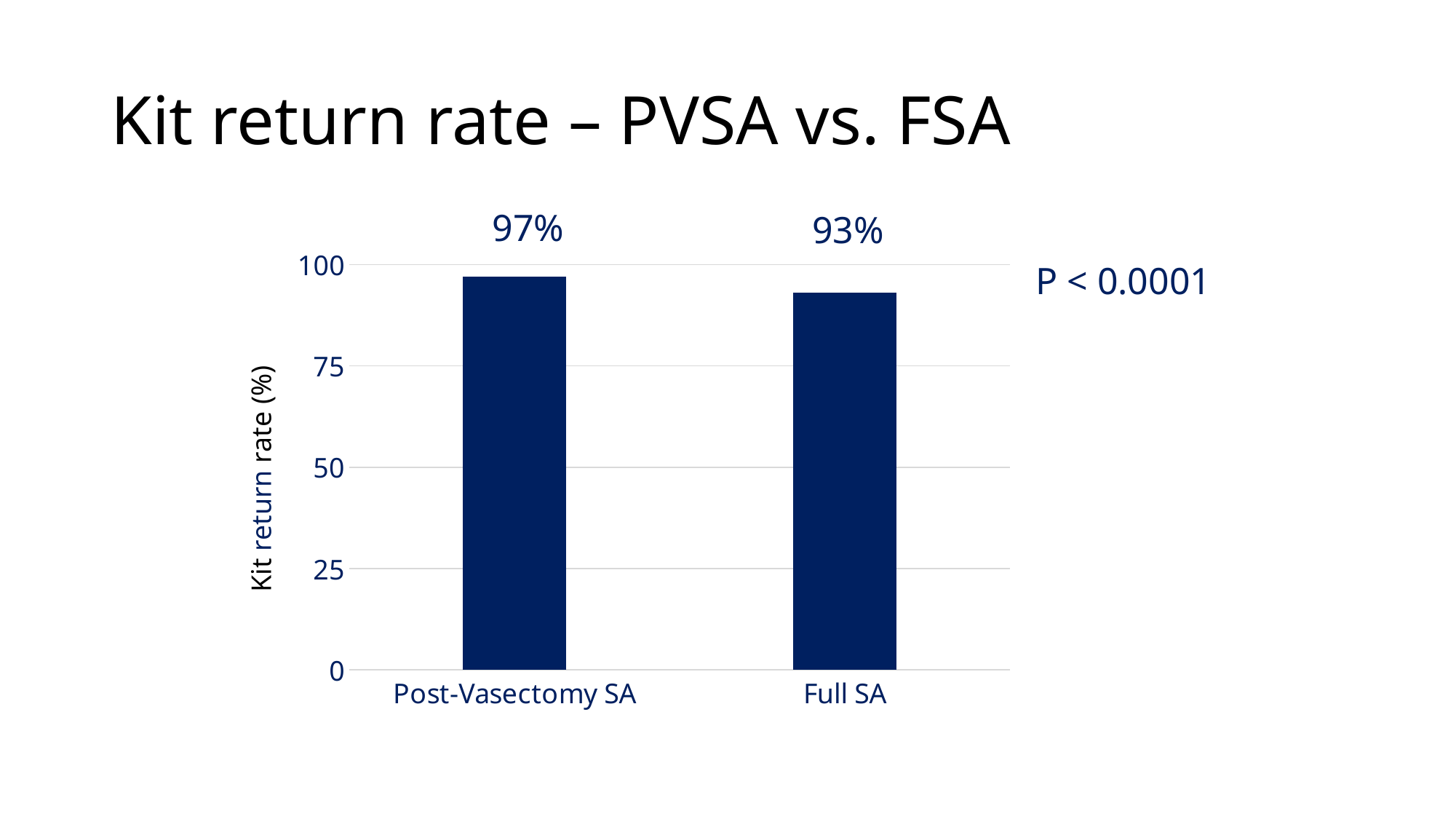
Which has a higher kit return rate, Post-Vasectomy SA or Full SA? Post-Vasectomy SA What kind of chart is shown on the slide? bar chart What is the kit return rate for Post-Vasectomy SA? 97% How many categories are shown on the x axis? 2 Which category has the highest kit return rate? Post-Vasectomy SA What is the difference in kit return rate between Post-Vasectomy SA and Full SA? 4% What is the kit return rate for Full SA? 93% Which category has the lowest kit return rate? Full SA What is the title of the slide? Kit return rate – PVSA vs. FSA Is the kit return rate for Full SA greater or less than 75? greater What is the label of the y axis? Kit return rate (%) What P value is shown next to the chart? P < 0.0001